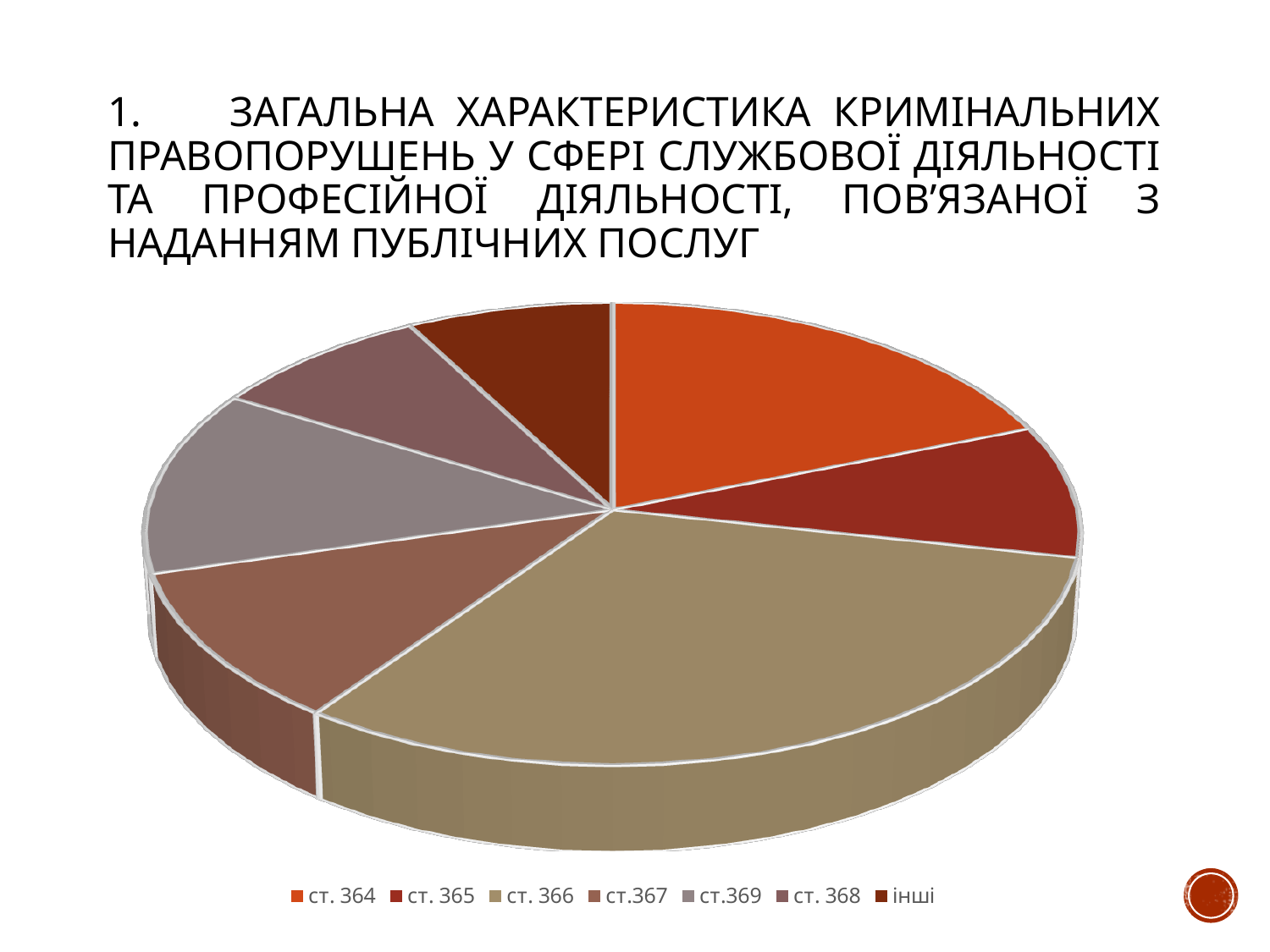
What is the first entry listed in the chart legend? ст. 364 Which slice is larger, ст.367 or ст. 365? ст.367 Which slice is larger, ст. 366 or ст. 364? ст. 366 What kind of chart is shown on the slide? pie chart Which slice is larger, ст. 366 or ст.369? ст. 366 How many slices does the pie chart have? 7 Which category has the largest slice of the pie chart? ст. 366 What is the last entry listed in the chart legend? інші How many entries are listed in the chart legend? 7